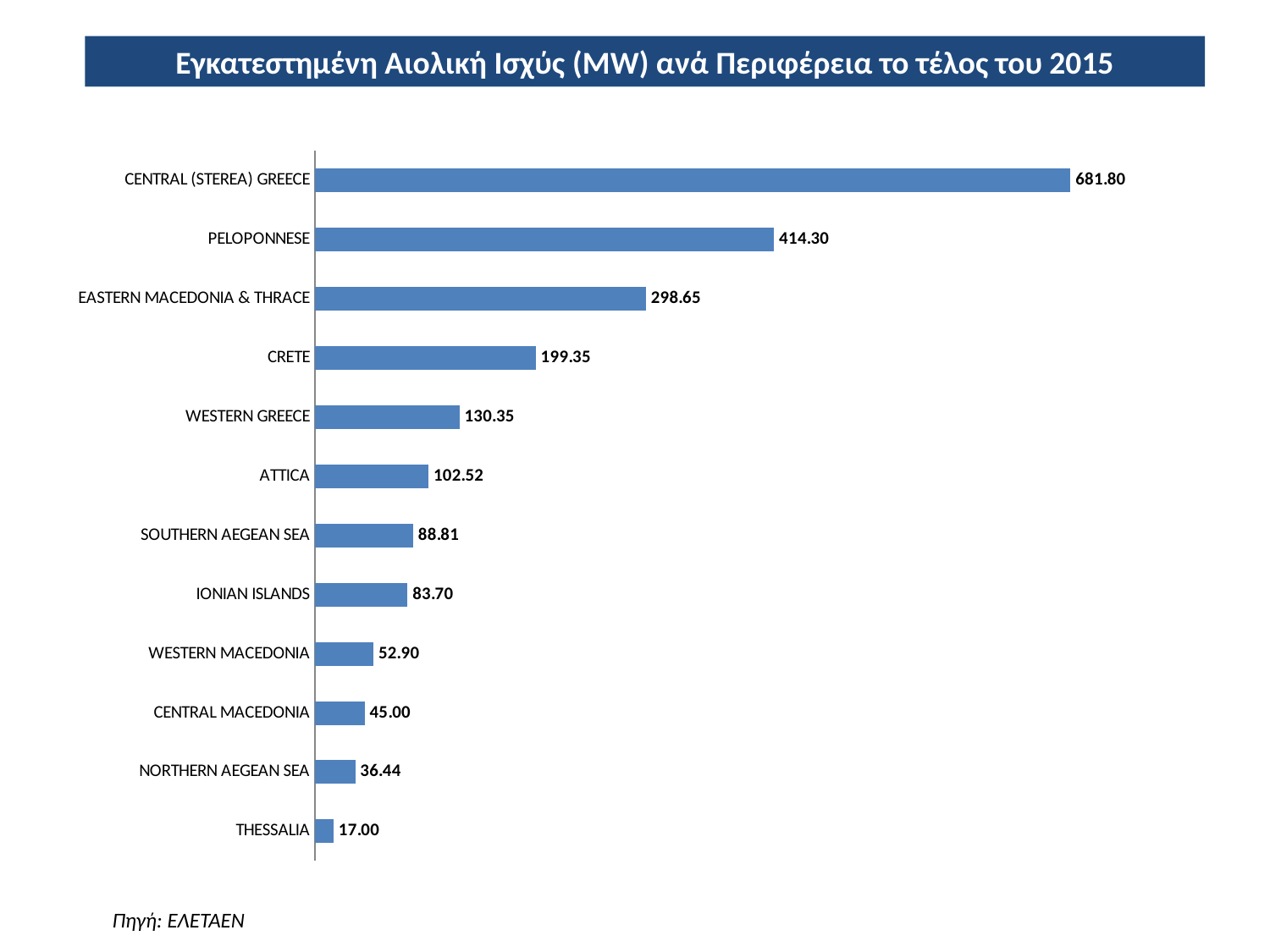
Which is larger, the value for WESTERN GREECE or the value for CRETE? CRETE What value is shown for WESTERN MACEDONIA? 52.90 Which region has the highest installed wind capacity? CENTRAL (STEREA) GREECE What is the value for NORTHERN AEGEAN SEA? 36.44 What kind of chart is shown on the slide? Bar chart What is the source cited below the chart? ΕΛΕΤΑΕΝ What is the difference between the values for PELOPONNESE and EASTERN MACEDONIA & THRACE? 115.65 How many regions are shown in the chart? 12 What is the installed wind capacity (MW) for CRETE? 199.35 What is the difference between the values for ATTICA and SOUTHERN AEGEAN SEA? 13.71 What is the title of the chart? Εγκατεστημένη Αιολική Ισχύς (MW) ανά Περιφέρεια το τέλος του 2015 Which region has the lowest installed wind capacity? THESSALIA